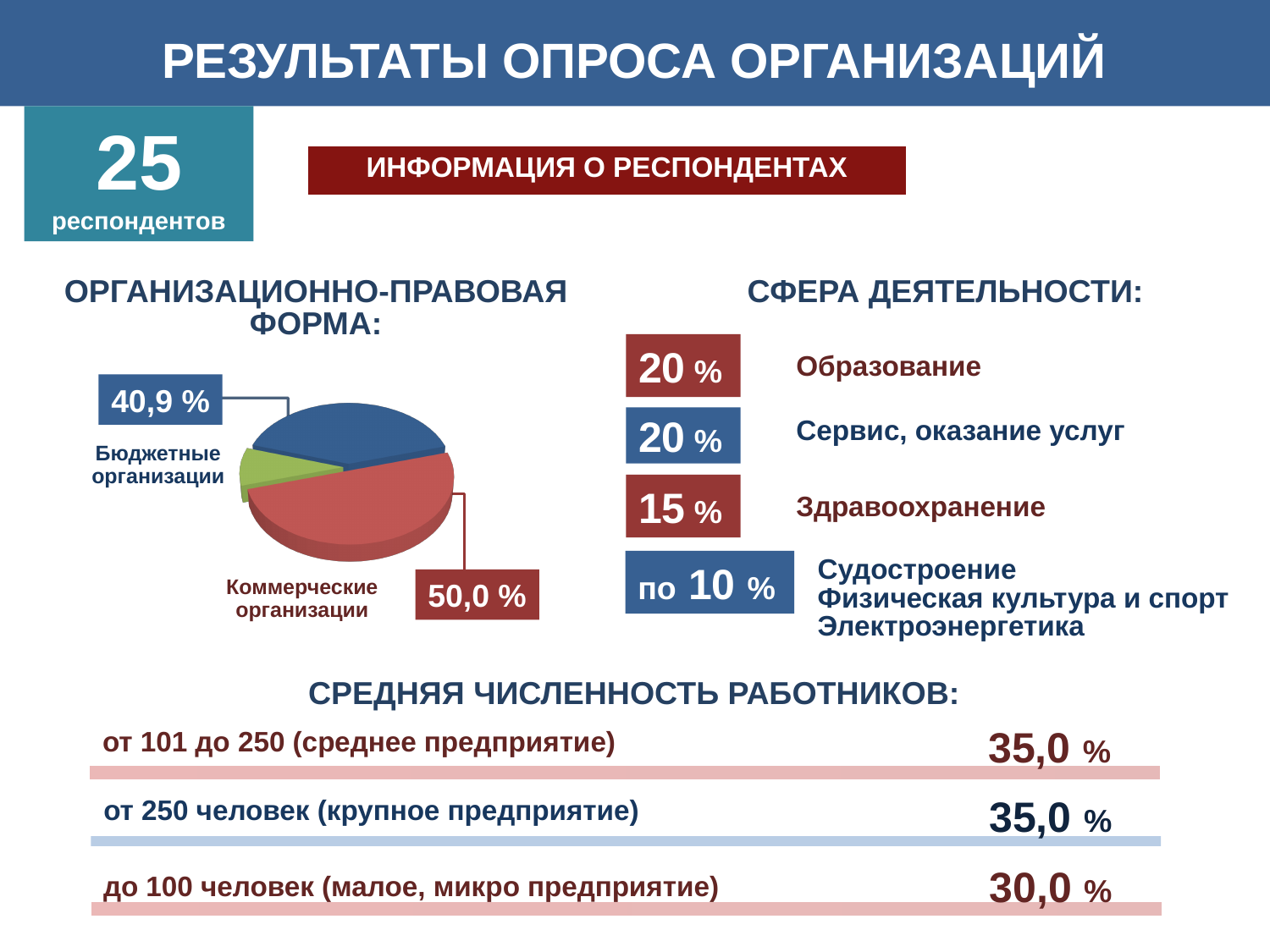
What type of chart is shown under «ОРГАНИЗАЦИОННО-ПРАВОВАЯ ФОРМА»? Pie chart In the pie chart under «ОРГАНИЗАЦИОННО-ПРАВОВАЯ ФОРМА», which is larger: the share of «Бюджетные организации» or «Коммерческие организации»? Коммерческие организации In the pie chart under «ОРГАНИЗАЦИОННО-ПРАВОВАЯ ФОРМА», what share is shown for «Коммерческие организации»? 50,0 % In the pie chart under «ОРГАНИЗАЦИОННО-ПРАВОВАЯ ФОРМА», what colour is the slice for «Коммерческие организации»? Red In the pie chart under «ОРГАНИЗАЦИОННО-ПРАВОВАЯ ФОРМА», by how many percentage points does the share of «Коммерческие организации» exceed that of «Бюджетные организации»? 9,1 % In the pie chart under «ОРГАНИЗАЦИОННО-ПРАВОВАЯ ФОРМА», what colour is the slice for «Бюджетные организации»? Blue How many slices does the pie chart under «ОРГАНИЗАЦИОННО-ПРАВОВАЯ ФОРМА» have? 3 In the pie chart under «ОРГАНИЗАЦИОННО-ПРАВОВАЯ ФОРМА», which labelled category has the largest share? Коммерческие организации In the pie chart under «ОРГАНИЗАЦИОННО-ПРАВОВАЯ ФОРМА», what share is shown for «Бюджетные организации»? 40,9 %